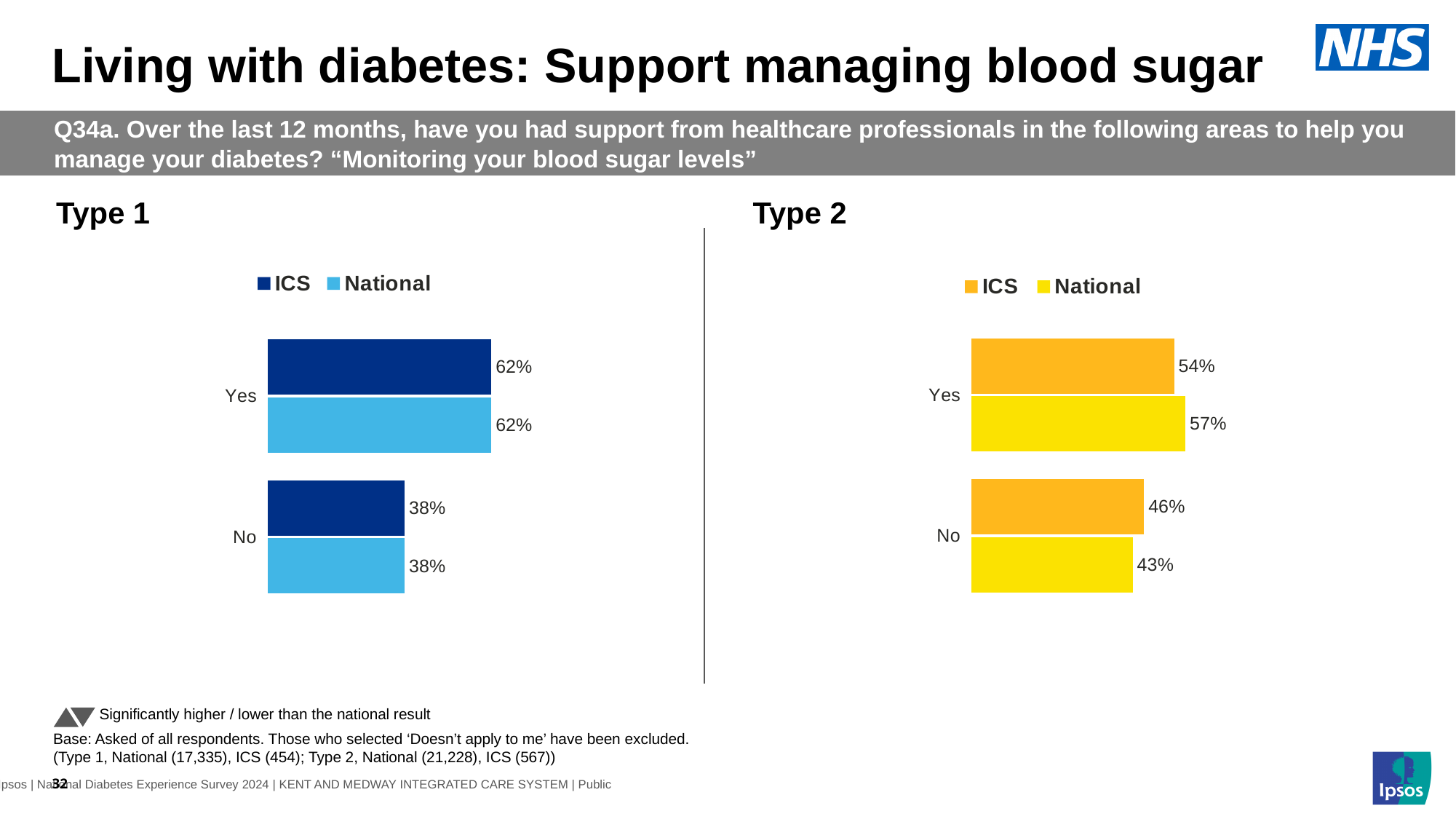
How many series does the legend of the Type 1 chart list? 2 In the Type 2 chart, what colour are the National bars? Yellow In the Type 2 chart, which is larger for No: ICS or National? ICS In the Type 2 chart, what is the National value for No? 43% In the Type 1 chart, what is the difference between the ICS values for Yes and No? 24% In the Type 1 chart, what is the ICS value for Yes? 62% What kind of chart is the Type 1 chart? Bar chart In the Type 1 chart, what is the National value for No? 38% In the Type 2 chart, which category has the highest National value? Yes How many categories are shown in the Type 2 chart? 2 In the Type 2 chart, what is the ICS value for Yes? 54% In the Type 2 chart, what is the difference between the National and ICS values for Yes? 3%